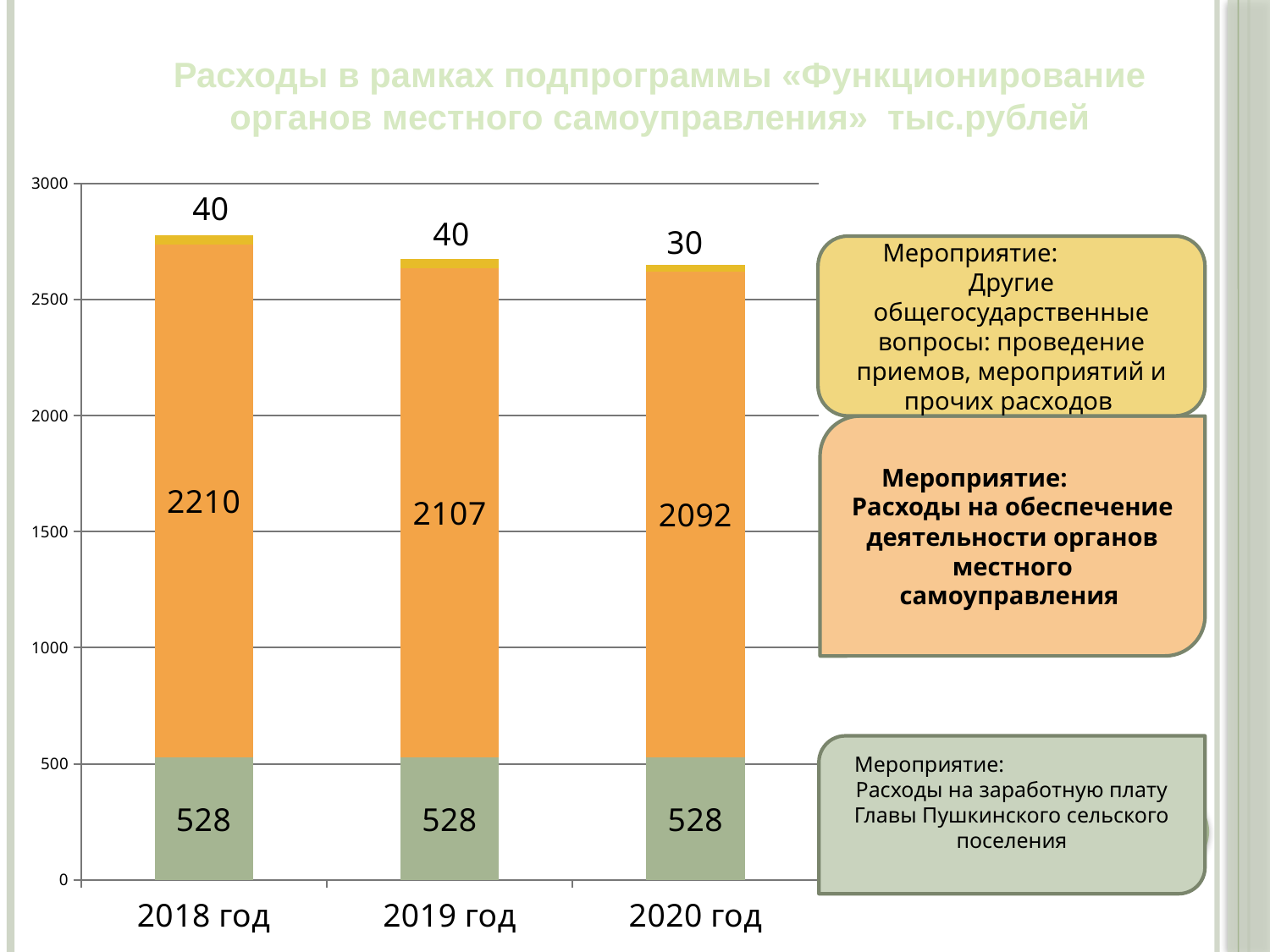
Which year has the highest value for the orange segment? 2018 год Does the orange segment value rise or fall from 2018 год to 2020 год? fall What is the value of the orange segment for 2020 год? 2092 Is the total height of the 2020 год bar greater or less than 2500? greater What is the difference between the orange segment values for 2018 год and 2019 год? 103 Which year has the lowest value for the top (yellow) segment? 2020 год How many years (categories) are shown on the x axis? 3 What is the value of the orange segment (Расходы на обеспечение деятельности органов местного самоуправления) for 2018 год? 2210 What is the value of the green segment (Расходы на заработную плату Главы) for 2019 год? 528 What type of chart is shown on the slide? stacked bar chart What is the total of the stacked bar for 2018 год? 2778 What is the value of the top (yellow) segment for 2020 год? 30